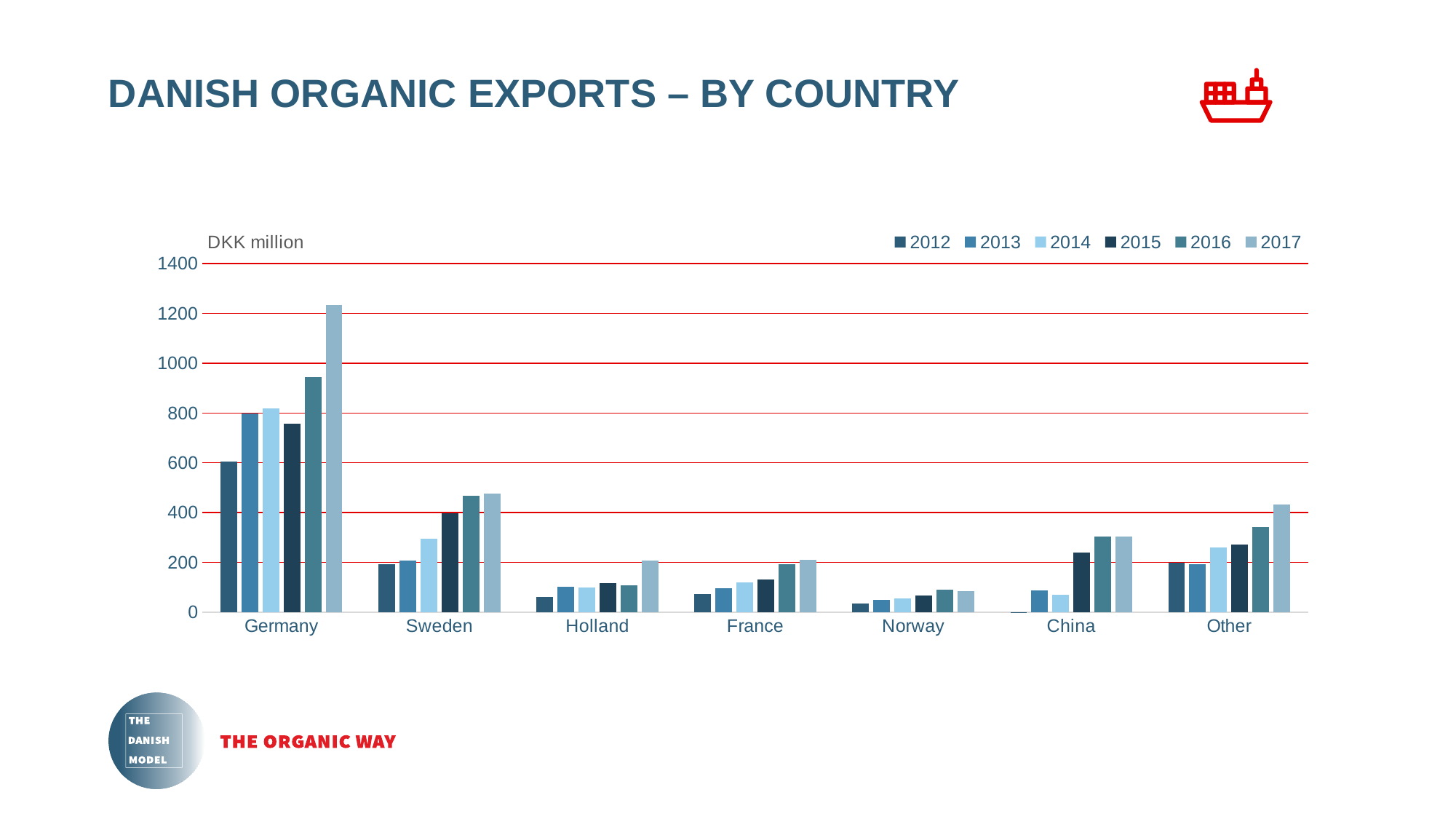
Is the value for Norway in 2016 greater or less than 200? less Do the values for Sweden rise or fall from 2012 to 2017? rise How many series does the legend list? 6 What unit is shown for the y axis? DKK million Which country has the lowest value for 2012? China Is the value for Germany in 2017 greater or less than 1000? greater How many countries/categories are shown on the x axis? 7 Which is larger, the 2016 value for Germany or the 2016 value for Sweden? Germany What kind of chart is shown on the slide? Bar chart Which country has the highest value for 2017? Germany Is the value for Sweden in 2017 greater or less than 400? greater